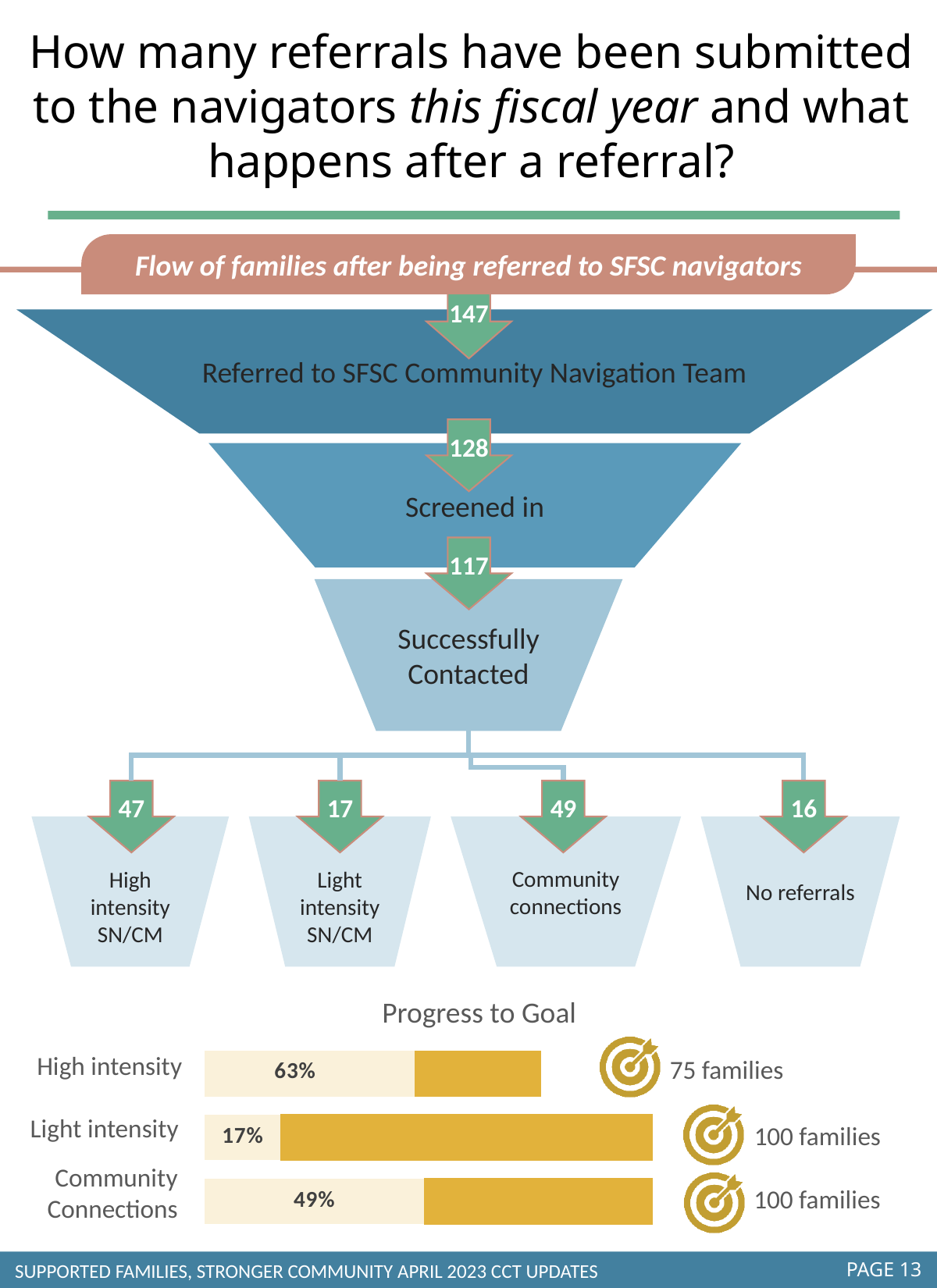
In the 'Progress to Goal' chart, what is the goal for High intensity? 75 families In the 'Progress to Goal' chart, what percentage of the goal has been reached for Light intensity? 17% In the funnel diagram, which of the four outcome categories below 'Successfully Contacted' has the highest number? Community connections In the funnel diagram, how many families were referred to the SFSC Community Navigation Team? 147 In the funnel diagram, what is the difference between the number referred (147) and the number screened in (128)? 19 In the funnel diagram, which of the four outcome categories below 'Successfully Contacted' has the lowest number? No referrals In the funnel diagram, how many families were screened in? 128 What kind of chart is the 'Progress to Goal' chart? Bar chart In the funnel diagram, how many outcome categories branch off from 'Successfully Contacted'? 4 In the funnel diagram, how many families went to Community connections? 49 In the funnel diagram, how many families were successfully contacted? 117 In the 'Progress to Goal' chart, which category has the highest percentage progress? High intensity